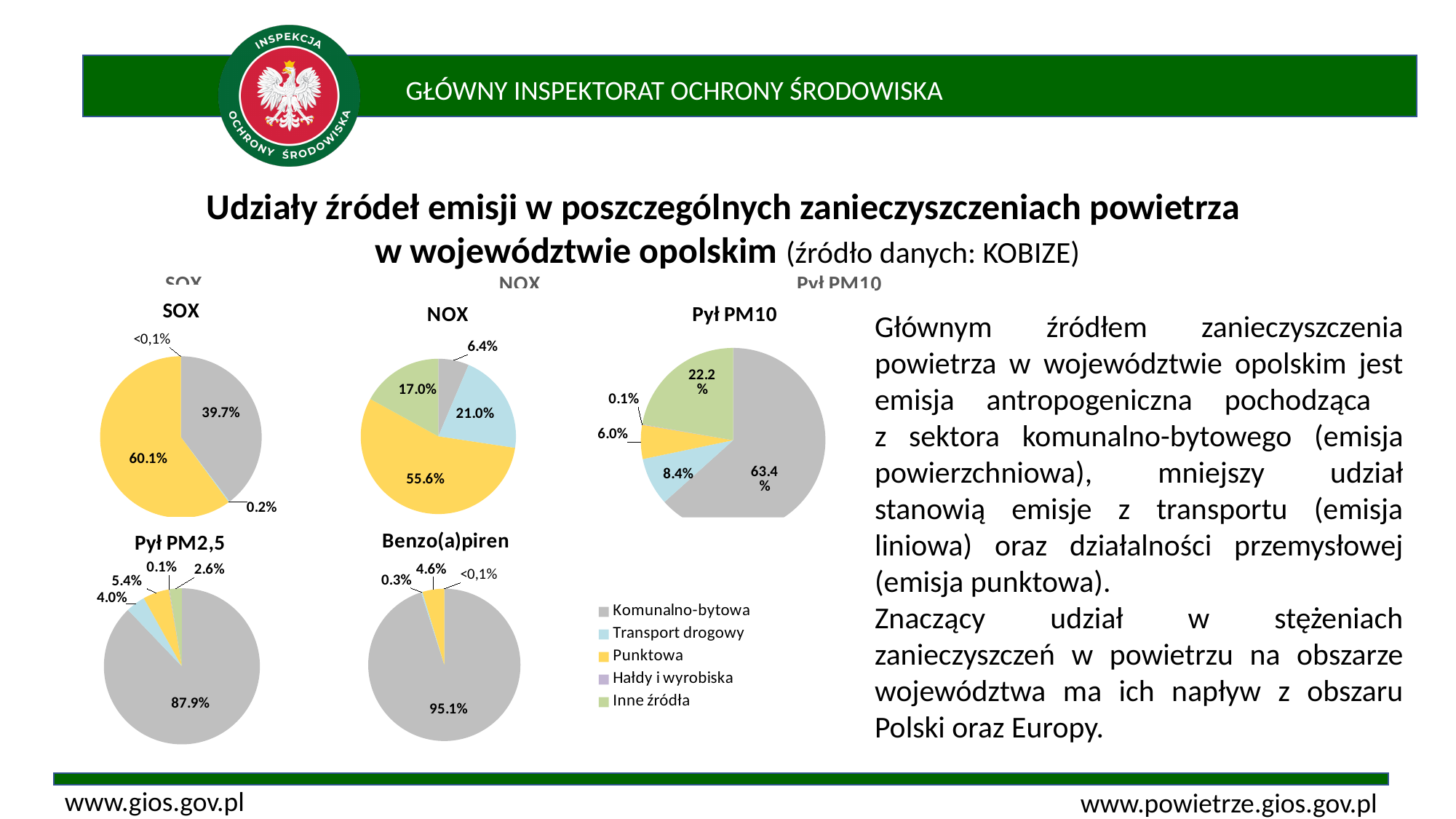
In the Benzo(a)piren pie chart, which source has the largest share? Komunalno-bytowa How many entries does the legend list? 5 How many pie charts are on the slide? 5 In the Pył PM10 pie chart, what share is labelled for the Inne źródła (green) slice? 22.2% In the Pył PM10 pie chart, what is the difference between the Komunalno-bytowa share and the Transport drogowy share? 55.0% Which is larger in the Pył PM2,5 pie chart: the Punktowa share or the Transport drogowy share? Punktowa What kind of charts are shown on the slide? Pie charts In the NOX pie chart, what share is labelled for the Transport drogowy (light blue) slice? 21.0% In the SOX pie chart, what share is labelled for the Komunalno-bytowa (grey) slice? 39.7% In the NOX pie chart, which source has the largest share? Punktowa